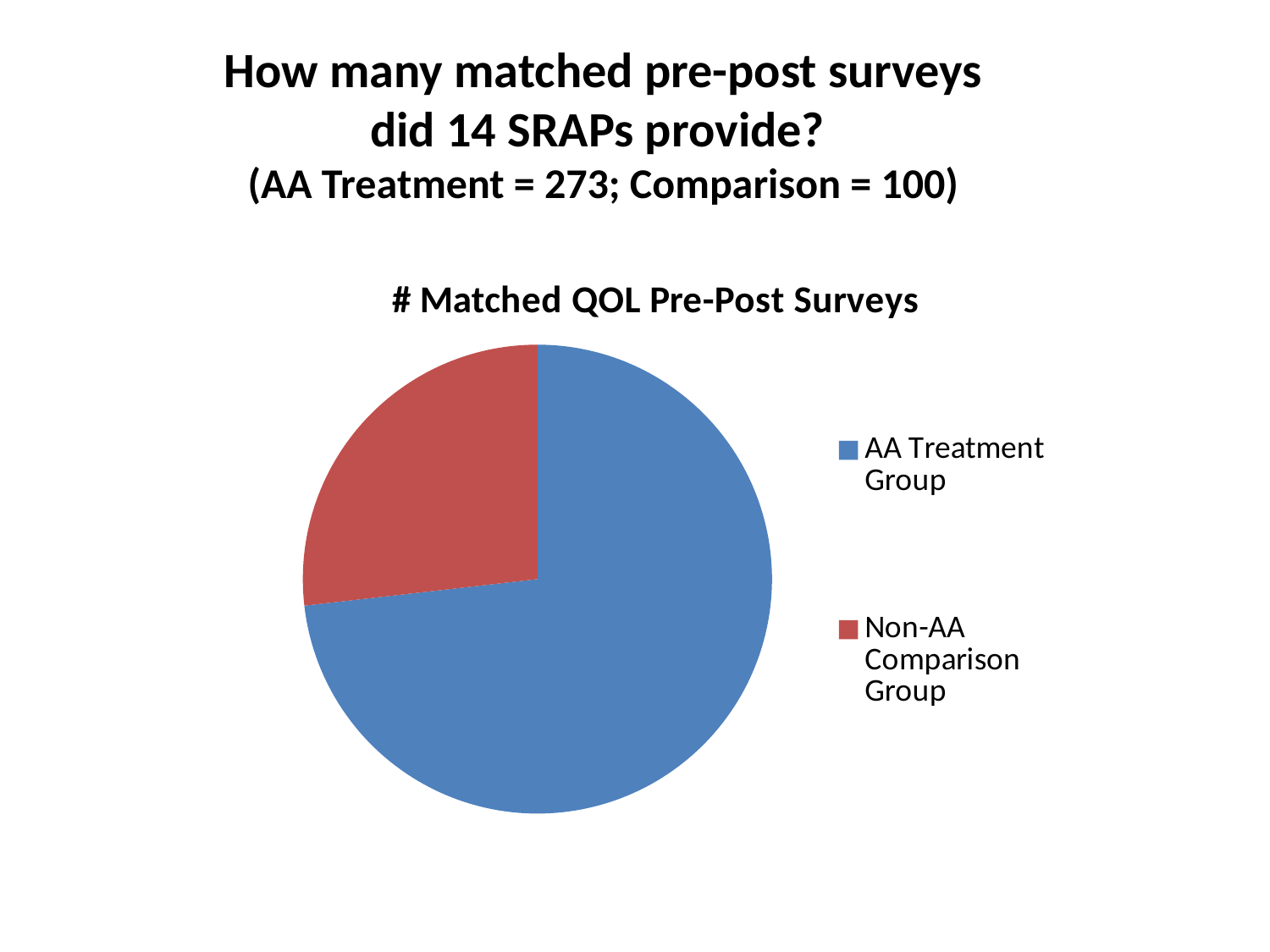
What is the total number of matched pre-post surveys across both groups? 373 How many entries does the legend list? 2 Which group has the smaller slice of the pie? Non-AA Comparison Group What colour is the slice for the Non-AA Comparison Group? red According to the slide, how many matched pre-post surveys did the AA Treatment group provide? 273 According to the slide, how many matched pre-post surveys did the Comparison group provide? 100 What kind of chart is shown on the slide? pie chart Is the AA Treatment Group slice larger or smaller than the Non-AA Comparison Group slice? larger Which group has the larger slice of the pie? AA Treatment Group What is the title of the chart? # Matched QOL Pre-Post Surveys How many more matched surveys did the AA Treatment group provide than the Comparison group? 173 How many slices does the pie chart have? 2